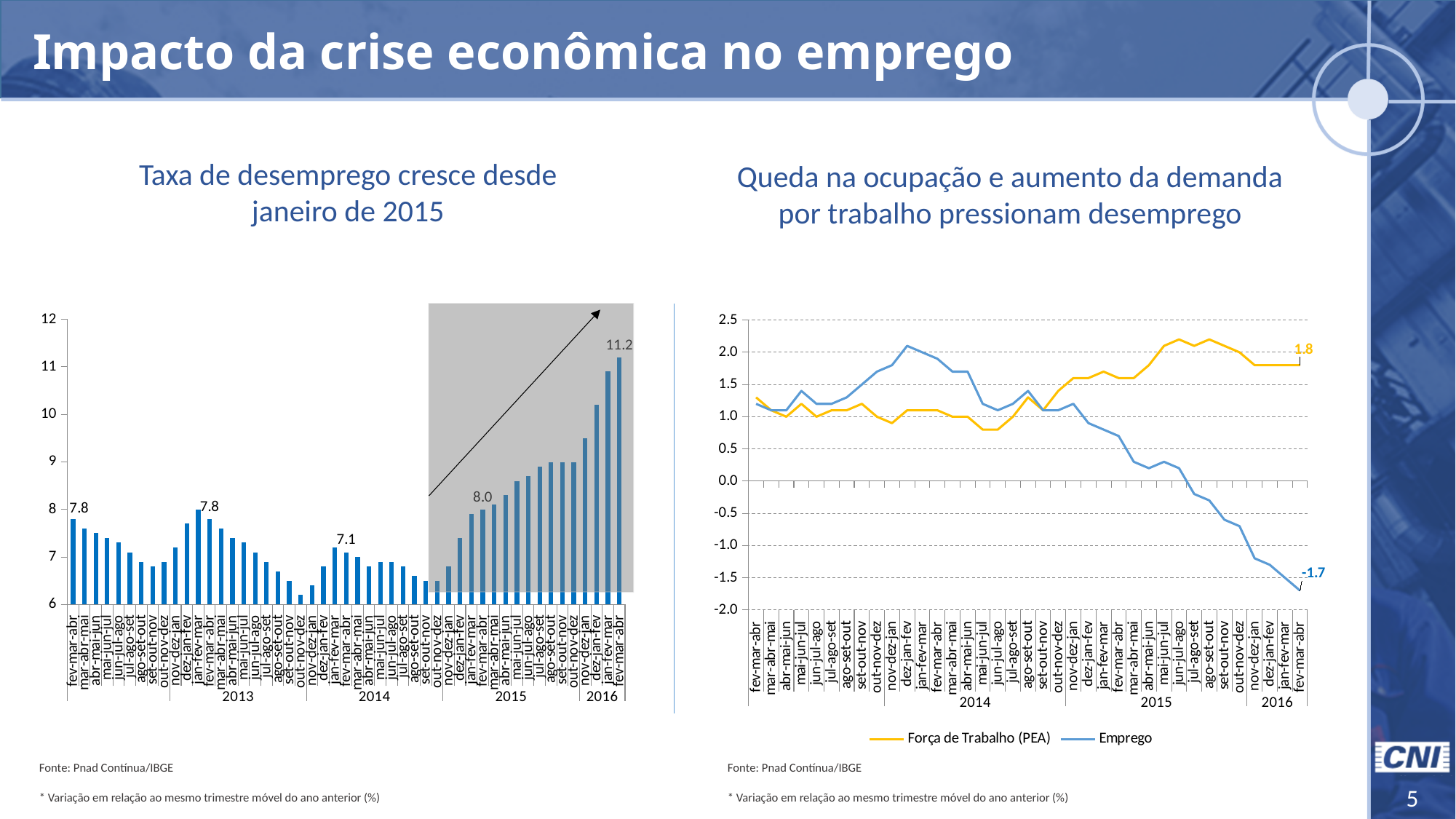
In the left chart, what is the unemployment rate labelled for fev-mar-abr 2016? 11.2 In the right chart, what is the final labelled value of the Força de Trabalho (PEA) series? 1.8 In the right chart, what is the final labelled value of the Emprego series? -1.7 What kind of chart is the right chart, 'Queda na ocupação e aumento da demanda por trabalho pressionam desemprego'? line chart How many series does the legend of the right chart list? 2 In the right chart, does the Emprego series rise or fall over 2015 and 2016? fall In the left chart, is the value for jan-fev-mar 2016 greater or less than 10? greater In the left chart, which period has the highest bar? fev-mar-abr 2016 In the left chart, what is the difference between the labelled values 11.2 (fev-mar-abr 2016) and 8.0 (2015)? 3.2 What kind of chart is the left chart, 'Taxa de desemprego cresce desde janeiro de 2015'? bar chart In the left chart, what value is labelled on the first bar, fev-mar-abr 2013? 7.8 In the left chart, is the value for out-nov-dez 2014 greater or less than 7? less